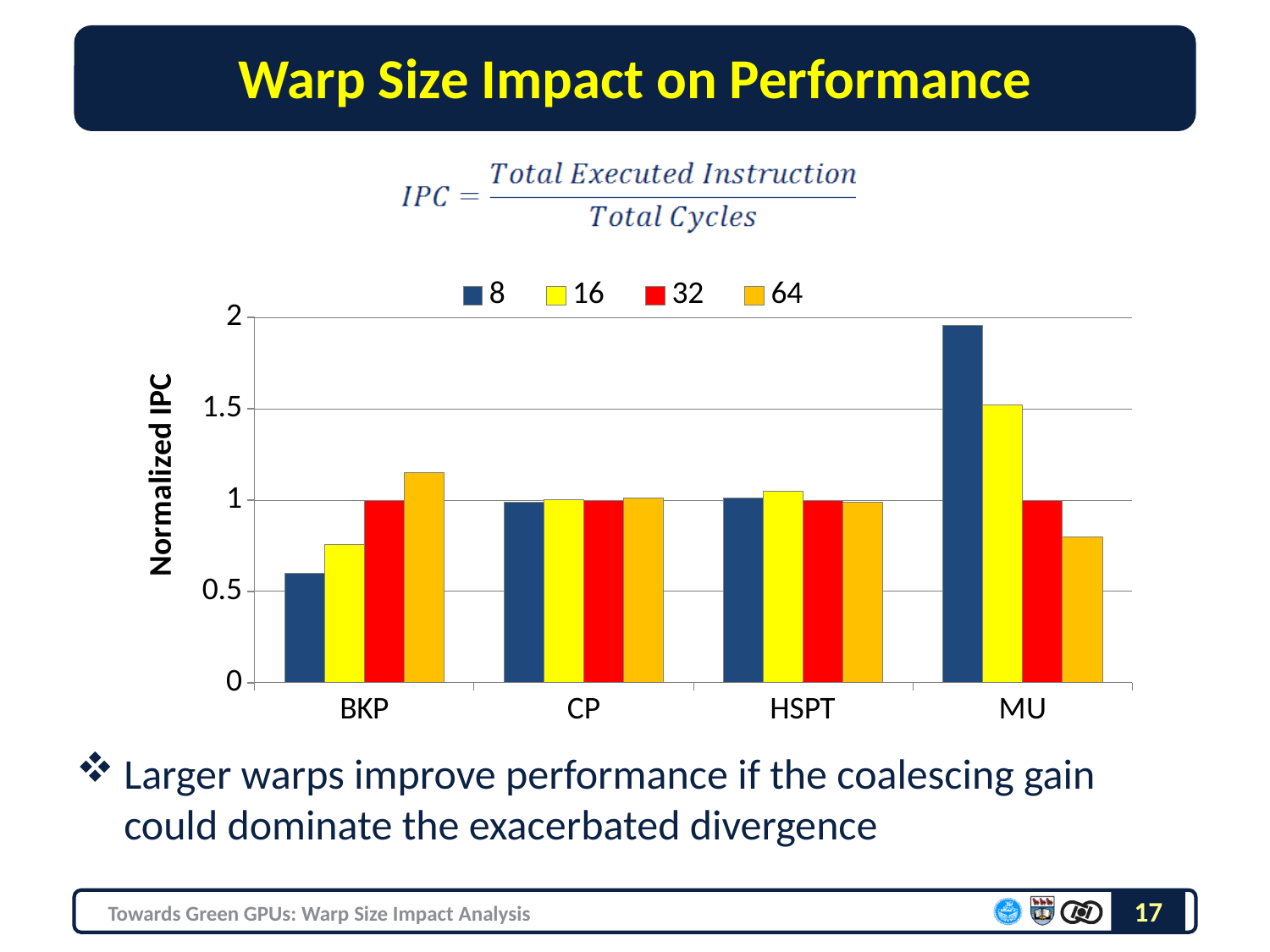
How many benchmark categories are shown on the x axis? 4 For BKP, does the Normalized IPC rise or fall as the warp size increases from 8 to 64? rise Which benchmark has the lowest Normalized IPC for warp size 8? BKP How many series does the legend list? 4 For MU, which is larger: the Normalized IPC for warp size 16 or for warp size 64? warp size 16 For BKP, which warp size gives the highest Normalized IPC? 64 What kind of chart is shown on the slide? bar chart What is the label of the y axis? Normalized IPC For MU, which warp size gives the lowest Normalized IPC? 64 Is the Normalized IPC for warp size 8 on MU greater or less than 1.5? greater Is the Normalized IPC for warp size 8 on BKP greater or less than 1? less Which benchmark has the highest Normalized IPC for warp size 8? MU